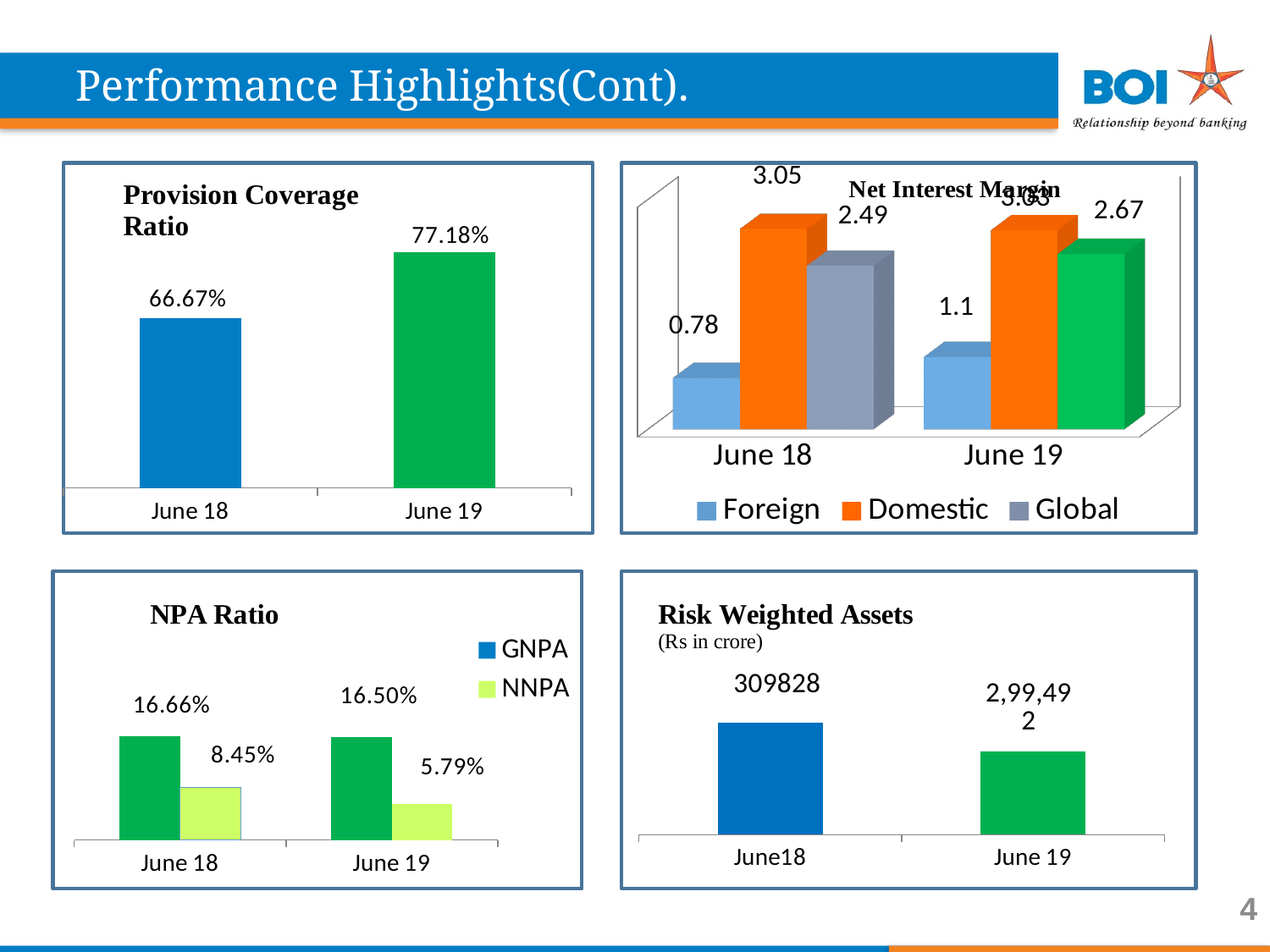
In the Provision Coverage Ratio chart, what is the value for June 19? 77.18% In the Net Interest Margin chart, what is the Foreign value for June 18? 0.78 In the Net Interest Margin chart, how many series does the legend list? 3 In the NPA Ratio chart, what is the NNPA value for June 19? 5.79% In the Risk Weighted Assets chart, what is the value for June18? 309828 In the NPA Ratio chart, what is the difference between the NNPA values for June 18 and June 19? 2.66% In the Net Interest Margin chart, what is the Global value for June 19? 2.67 In the NPA Ratio chart, which is larger: GNPA for June 18 or GNPA for June 19? GNPA for June 18 In the Net Interest Margin chart, which series has the lowest value for June 18? Foreign What kind of chart is the Provision Coverage Ratio chart? bar chart In the Risk Weighted Assets chart, do the values rise or fall from June18 to June 19? fall In the Provision Coverage Ratio chart, what is the difference between the June 19 and June 18 values? 10.51%